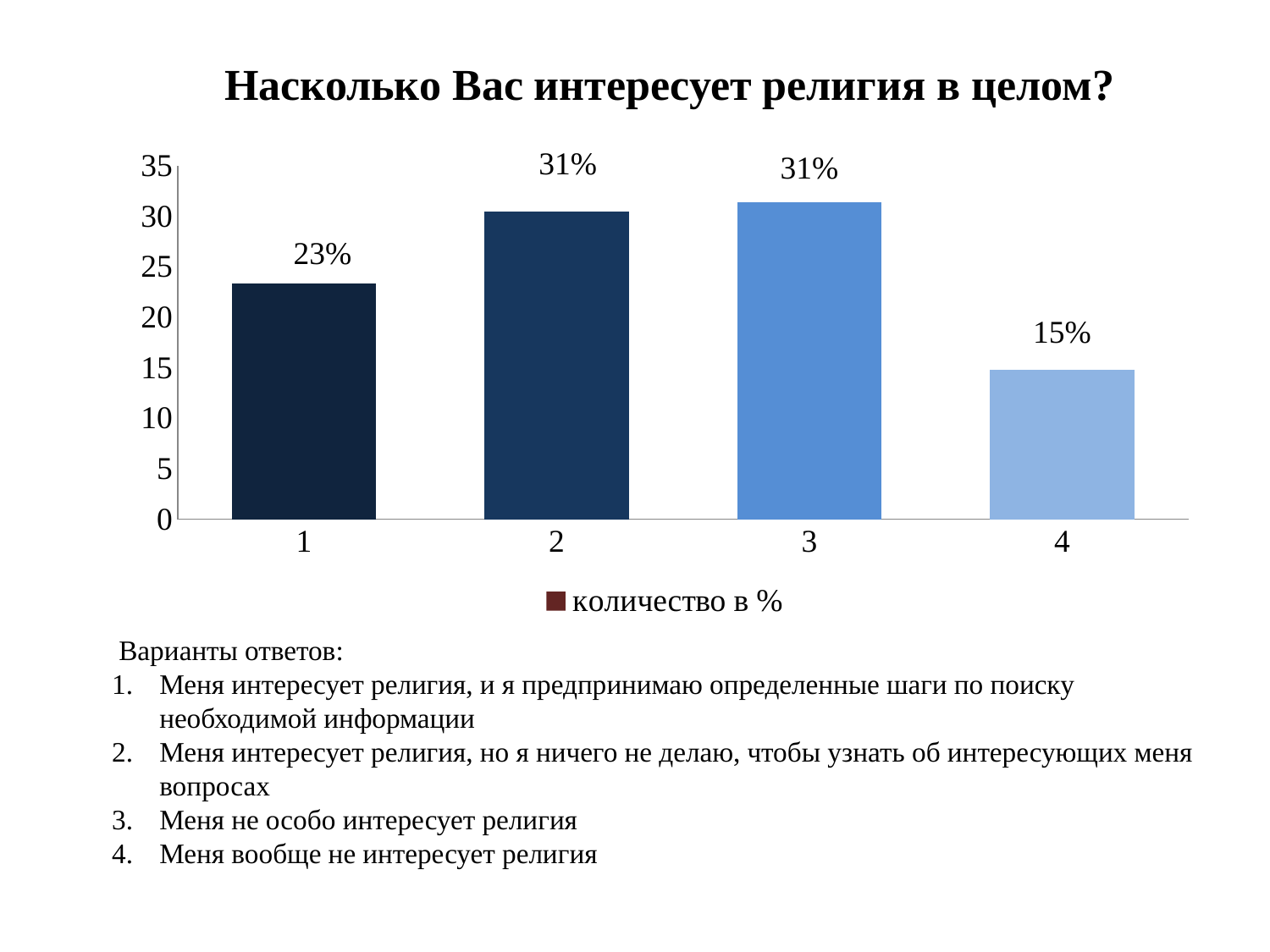
What is the title of the chart? Насколько Вас интересует религия в целом? Which is larger, the value for category 1 or the value for category 4? category 1 Is the value for category 1 greater or less than 20? greater How many series does the legend list? 1 What kind of chart is shown on the slide? bar chart Which category has the lowest value? 4 What is the difference between the values for category 1 and category 4? 8% What is the difference between the values for category 2 and category 4? 16% How many categories are shown on the x axis? 4 What is the value for category 2? 31% What is the value for category 4? 15% What is the value for category 1? 23%